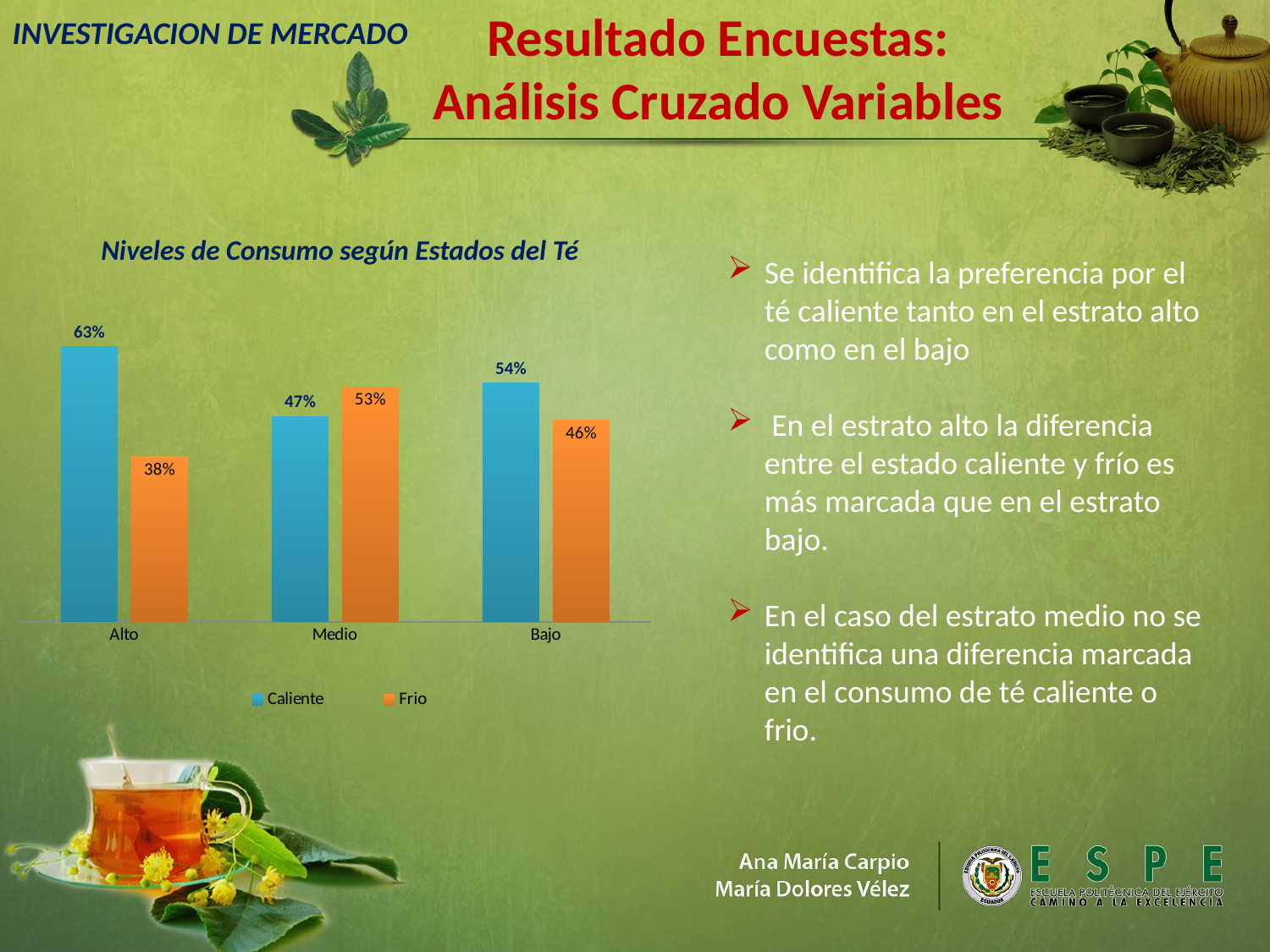
What kind of chart is shown on the slide? Bar chart How many series does the legend list? 2 What is the value for Caliente in the Alto category? 63% How many categories are shown on the x axis? 3 In the Medio category, which is larger, Caliente or Frio? Frio What is the difference between the Caliente and Frio values in the Alto category? 25% In the Bajo category, which is larger, Caliente or Frio? Caliente Which category has the highest Caliente value? Alto What is the value for Frio in the Medio category? 53% What is the title of the chart? Niveles de Consumo según Estados del Té Which category has the lowest Frio value? Alto What is the value for Frio in the Bajo category? 46%